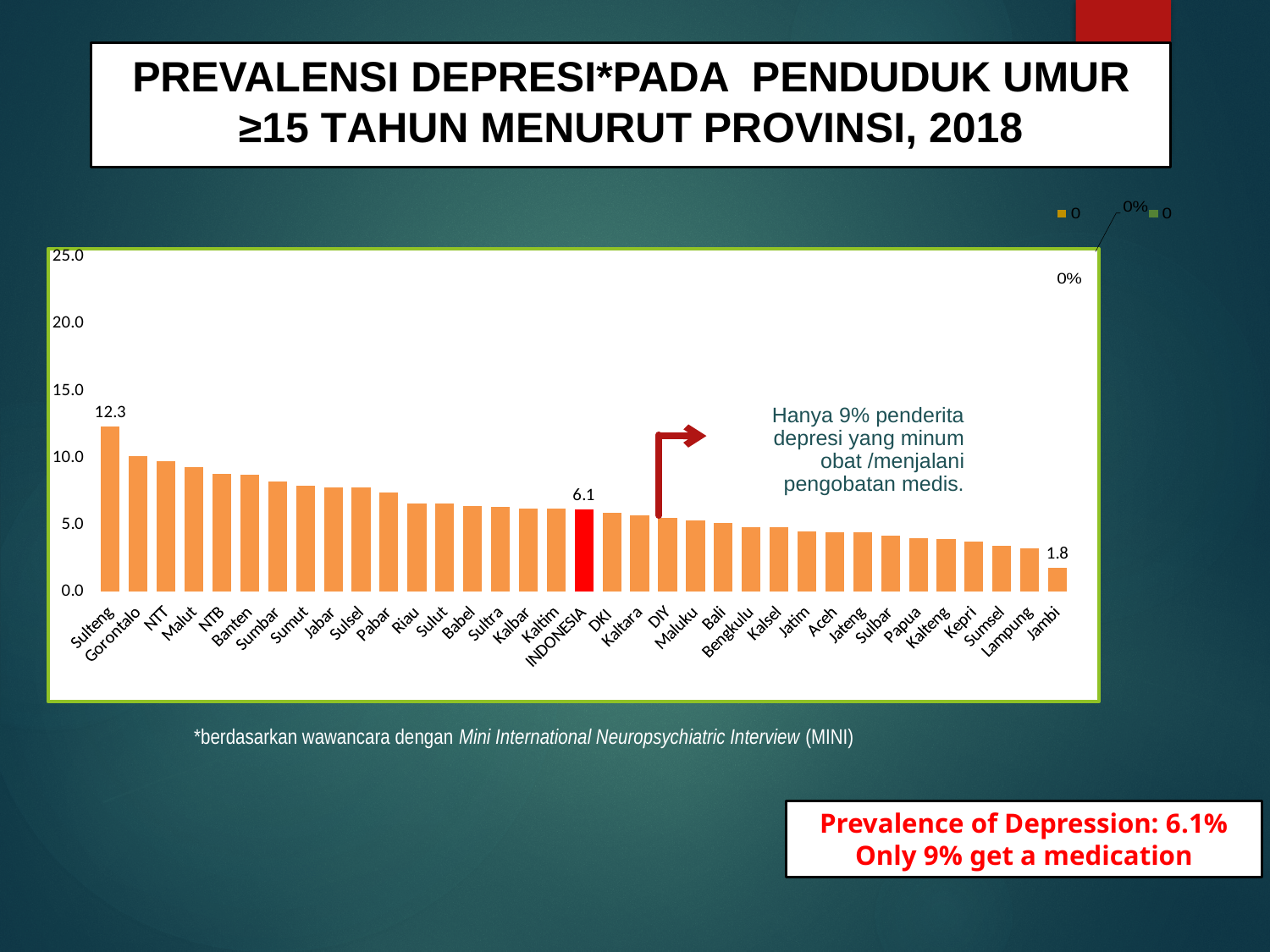
What is the difference between the values for Sulteng and Jambi? 10.5 Which is larger, the value for Gorontalo or the value for Jambi? Gorontalo What is the difference between the values for Sulteng and INDONESIA? 6.2 Do the values rise or fall from left to right along the x axis? fall Is the value for Banten greater or less than 10.0? less What is the value for INDONESIA? 6.1 What is the value for Jambi? 1.8 Which province has the highest value? Sulteng What is the value for Sulteng? 12.3 Is the value for Riau greater or less than 5.0? greater What kind of chart is shown on the slide? bar chart Which province has the lowest value? Jambi